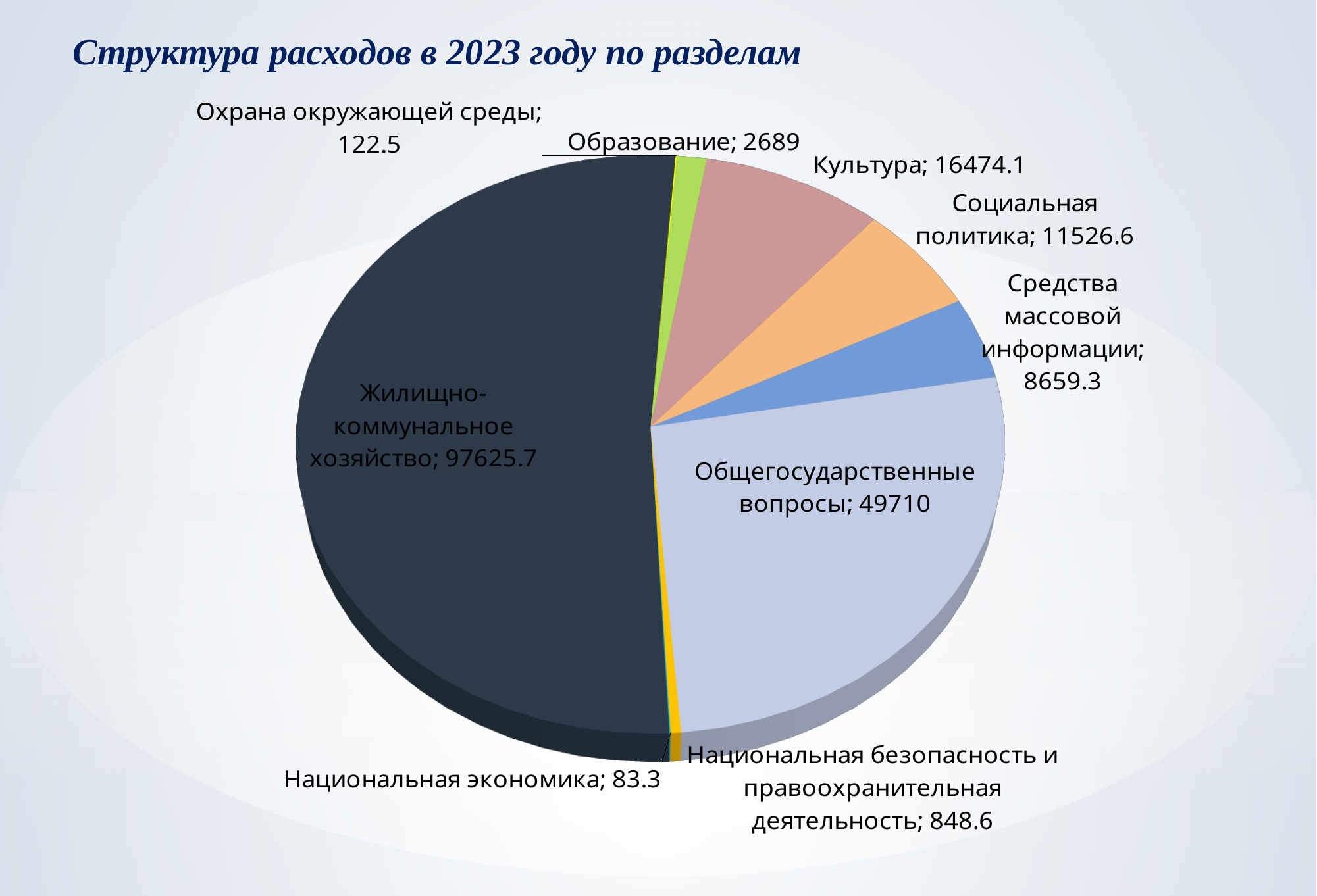
What is the value for Жилищно-коммунальное хозяйство? 97625.7 Which category has the smallest value? Национальная экономика What is the title of the chart? Структура расходов в 2023 году по разделам What is the difference between the values for Жилищно-коммунальное хозяйство and Общегосударственные вопросы? 47915.7 What is the value for Культура? 16474.1 What is the value for Национальная безопасность и правоохранительная деятельность? 848.6 How many categories (slices) does the pie chart have? 9 Which is larger, the value for Средства массовой информации or the value for Образование? Средства массовой информации What is the value for Общегосударственные вопросы? 49710 Which category has the largest value? Жилищно-коммунальное хозяйство What is the difference between the values for Культура and Социальная политика? 4947.5 What type of chart is shown on the slide? pie chart